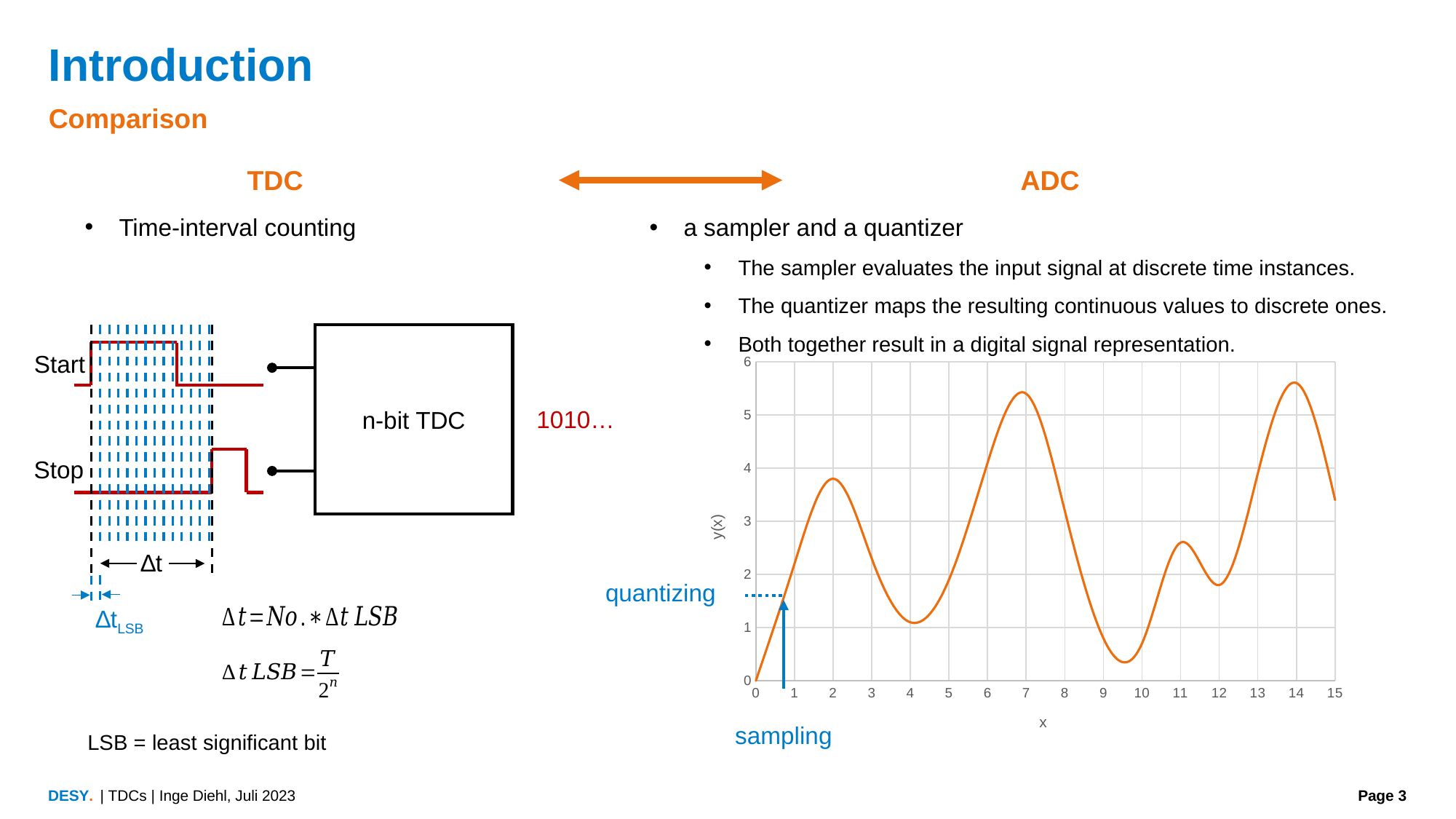
What is the highest tick value shown on the x axis of the chart? 15 What is the label of the x axis of the chart? x What is the label of the y axis of the chart? y(x) Is the value of y(x) at x = 11 greater or less than 2? greater What is the highest tick value shown on the y axis of the chart? 6 Is the value of y(x) at x = 4 greater or less than 2? less Does the curve rise or fall as x goes from 0 to 2? rise Which is larger, the value of y(x) at x = 7 or at x = 2? x = 7 Is the value of y(x) at x = 2 greater or less than 3? greater What kind of chart is shown on the right side of the slide? line chart How many tick labels are shown on the x axis of the chart? 16